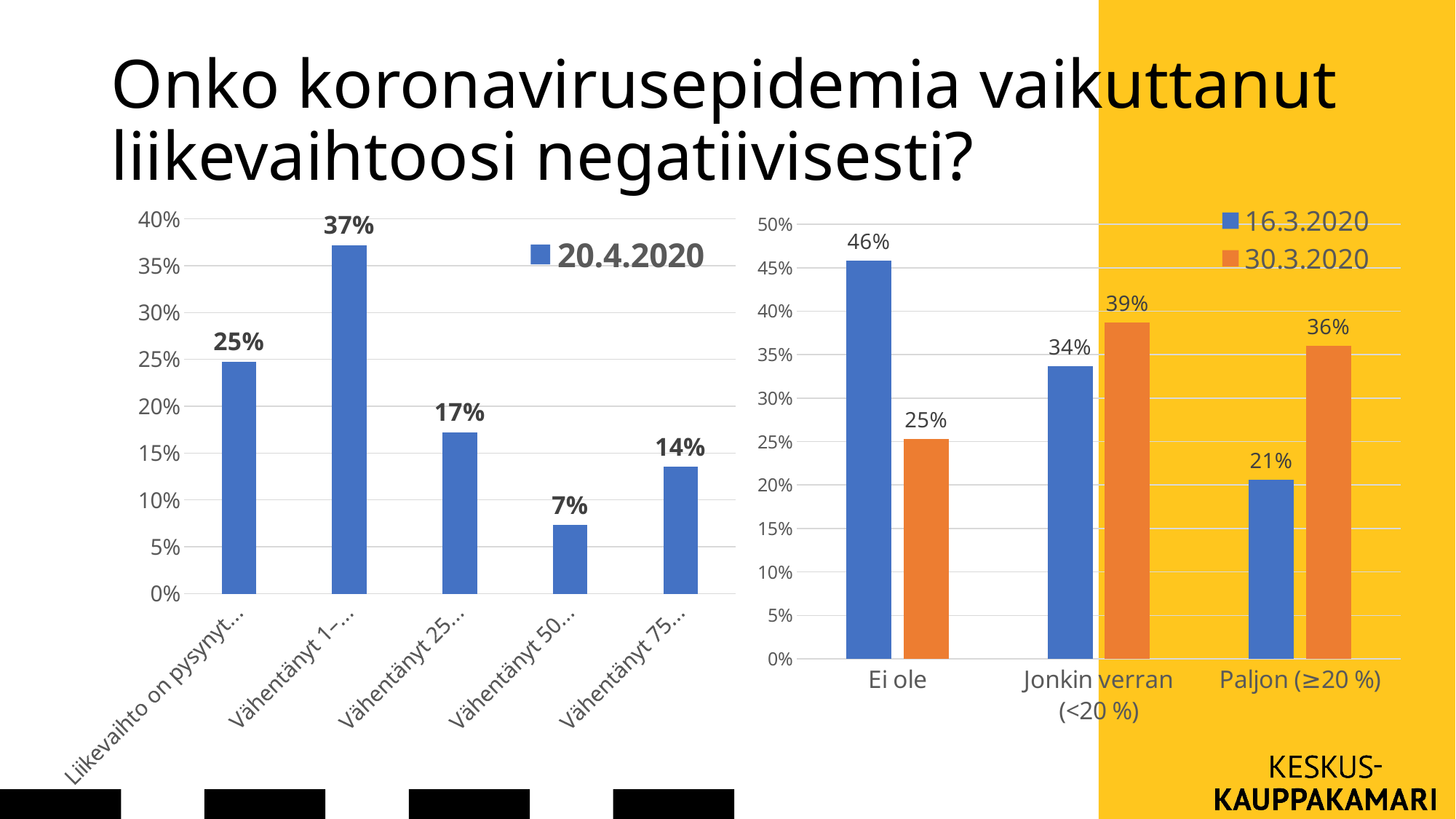
In the right chart, for 'Jonkin verran (<20 %)', which series has the larger value, 16.3.2020 or 30.3.2020? 30.3.2020 In the left chart, what date does the legend show? 20.4.2020 How many series does the legend of the right chart list? 2 In the right chart, which category has the highest value in the 30.3.2020 series? Jonkin verran (<20 %) In the left chart, what is the difference between the highest bar (37%) and the lowest bar (7%)? 30% In the left chart, which bar is the lowest? The fourth bar (Vähentänyt 50...) What type of chart is the right chart? Bar chart In the left chart, what is the value of the second bar from the left (the one labelled 'Vähentänyt 1–...')? 37% In the left chart, how many bars are plotted? 5 In the right chart, what is the value for 'Paljon (≥20 %)' in the 30.3.2020 series? 36% In the right chart, what is the difference between the 16.3.2020 and 30.3.2020 values for 'Ei ole'? 21% In the right chart, what is the value for 'Ei ole' in the 16.3.2020 series? 46%